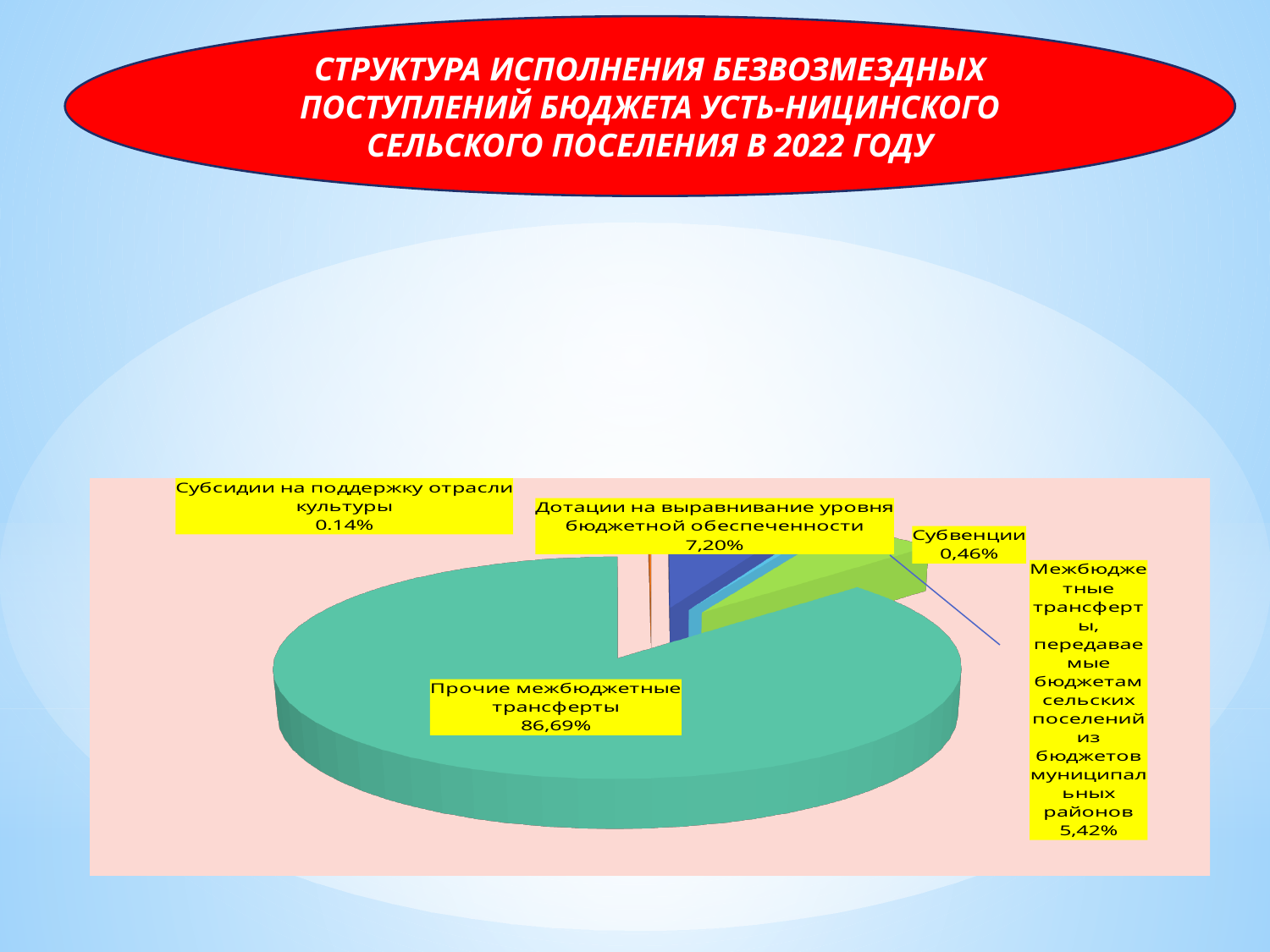
What is the difference in percentage points between "Прочие межбюджетные трансферты" and "Дотации на выравнивание уровня бюджетной обеспеченности"? 79,49% How many slices does the pie chart have? 5 What value is shown for "Субвенции"? 0,46% What value is shown for "Межбюджетные трансферты, передаваемые бюджетам сельских поселений из бюджетов муниципальных районов"? 5,42% What is the difference in percentage points between "Дотации на выравнивание уровня бюджетной обеспеченности" and "Межбюджетные трансферты, передаваемые бюджетам сельских поселений из бюджетов муниципальных районов"? 1,78% What value is shown for "Дотации на выравнивание уровня бюджетной обеспеченности"? 7,20% Which is larger: the share for "Дотации на выравнивание уровня бюджетной обеспеченности" or for "Субвенции"? Дотации на выравнивание уровня бюджетной обеспеченности What value is shown for "Субсидии на поддержку отрасли культуры"? 0.14% Which category has the largest share of the pie? Прочие межбюджетные трансферты What share of the pie is labelled for "Прочие межбюджетные трансферты"? 86,69% What kind of chart is shown on the slide? pie chart Which category has the smallest share of the pie? Субсидии на поддержку отрасли культуры